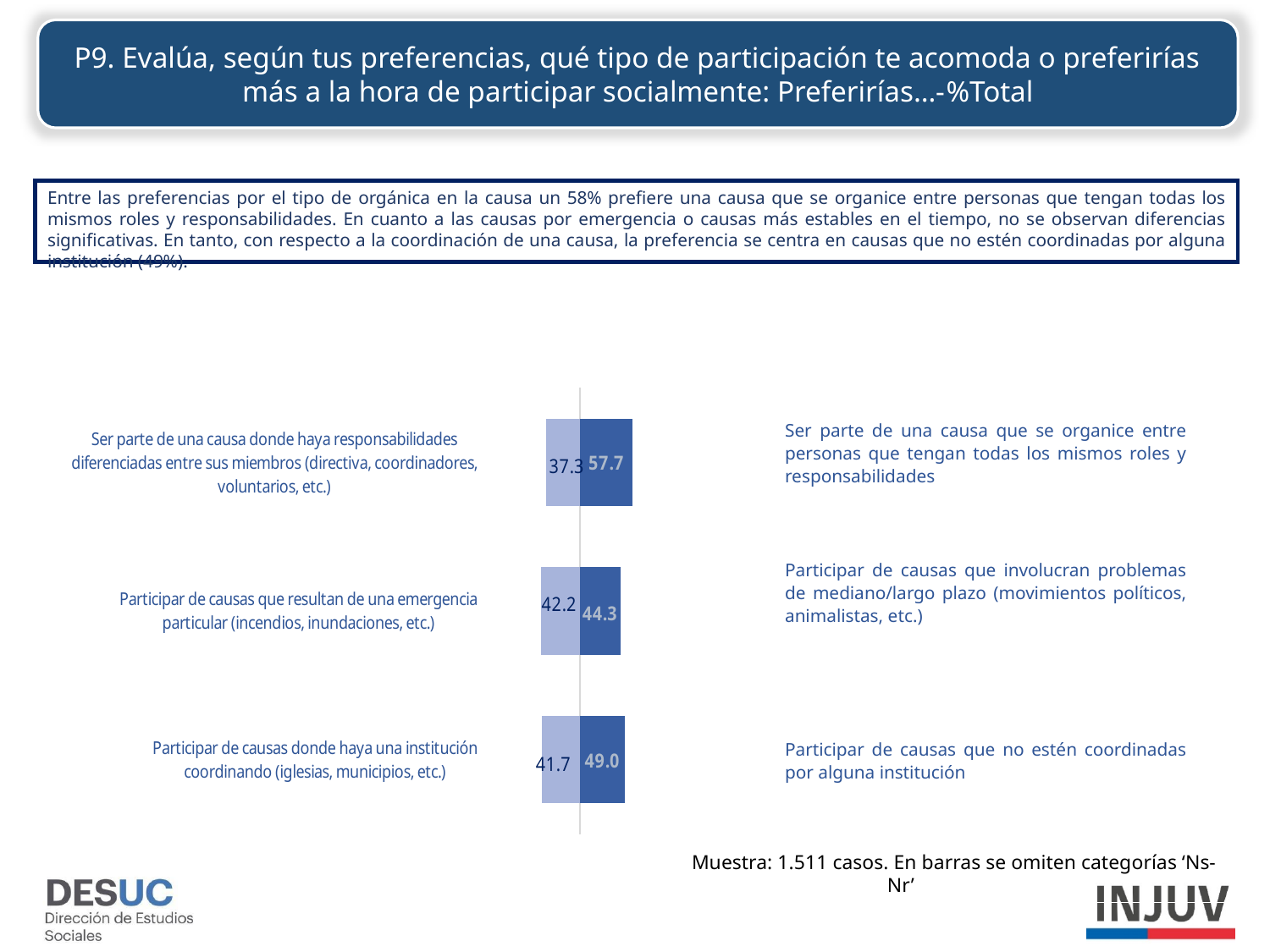
What value is shown for 'Participar de causas que no estén coordinadas por alguna institución'? 49.0 What value is shown for 'Ser parte de una causa donde haya responsabilidades diferenciadas entre sus miembros (directiva, coordinadores, voluntarios, etc.)'? 37.3 What value is shown for 'Participar de causas que resultan de una emergencia particular (incendios, inundaciones, etc.)'? 42.2 Which is larger: the value for 'Participar de causas que resultan de una emergencia particular' or the value for 'Participar de causas que involucran problemas de mediano/largo plazo'? Participar de causas que involucran problemas de mediano/largo plazo Which option has the highest value in the chart? Ser parte de una causa que se organice entre personas que tengan todas los mismos roles y responsabilidades What value is shown for 'Ser parte de una causa que se organice entre personas que tengan todas los mismos roles y responsabilidades'? 57.7 What value is shown for 'Participar de causas que involucran problemas de mediano/largo plazo (movimientos políticos, animalistas, etc.)'? 44.3 What kind of chart is shown on the slide? Bar chart What is the difference between the values for 'Participar de causas que no estén coordinadas por alguna institución' and 'Participar de causas donde haya una institución coordinando (iglesias, municipios, etc.)'? 7.3 How many pairs of opposing options are plotted in the chart? 3 Which option has the lowest value in the chart? Ser parte de una causa donde haya responsabilidades diferenciadas entre sus miembros (directiva, coordinadores, voluntarios, etc.) What value is shown for 'Participar de causas donde haya una institución coordinando (iglesias, municipios, etc.)'? 41.7